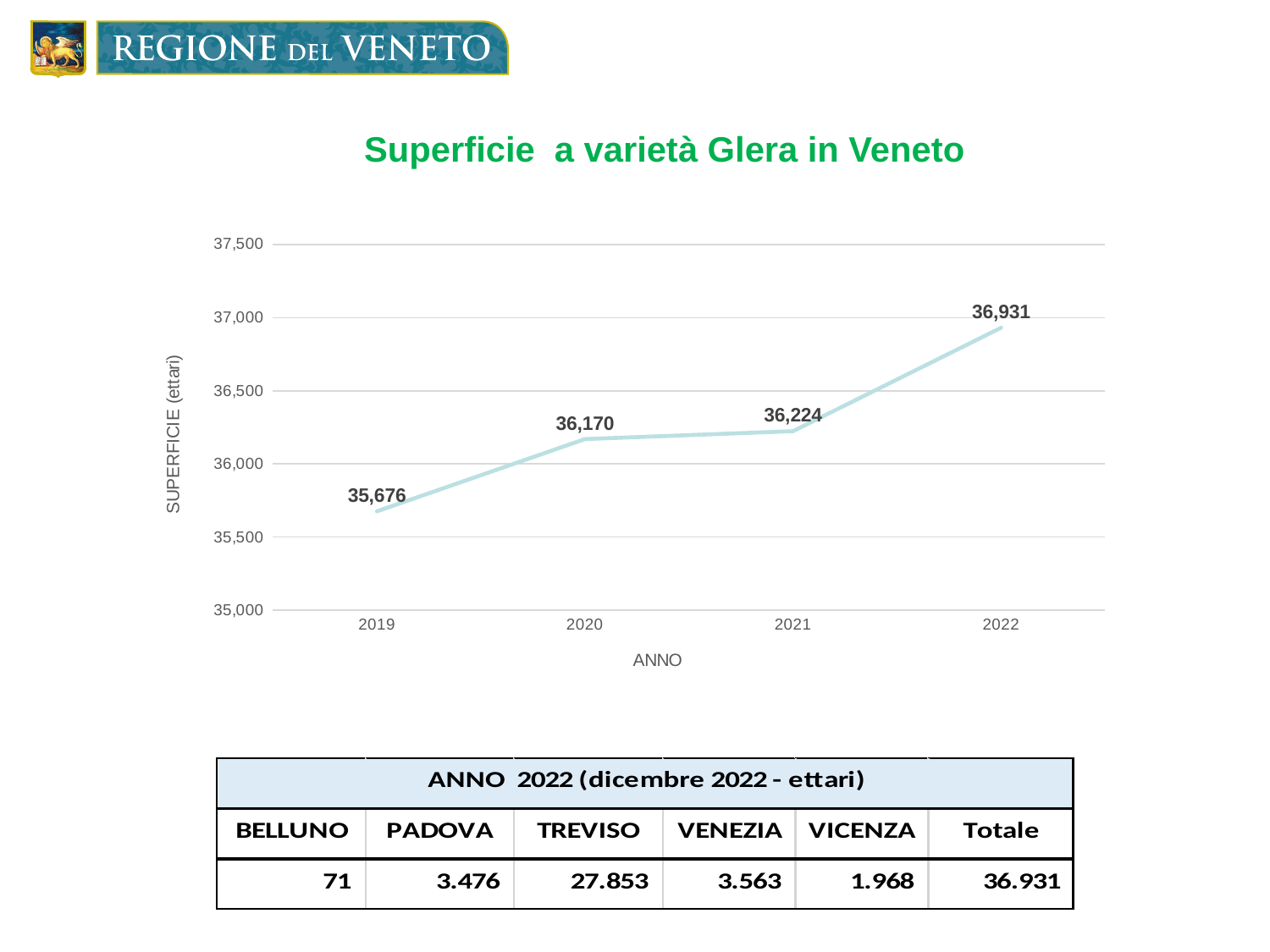
How many years are plotted on the chart? 4 What is the difference in surface area between 2020 and 2019? 494 What is the Glera surface area (ettari) in 2019? 35,676 What is the Glera surface area (ettari) in 2022? 36,931 What is the Glera surface area (ettari) in 2021? 36,224 Which year has the highest Glera surface area? 2022 What is the title of the chart? Superficie a varietà Glera in Veneto What type of chart is shown on the slide? Line chart Does the Glera surface area rise or fall from 2019 to 2022? Rises What is the Glera surface area (ettari) in 2020? 36,170 Which year has the lowest Glera surface area? 2019 What is the difference in surface area between 2022 and 2021? 707